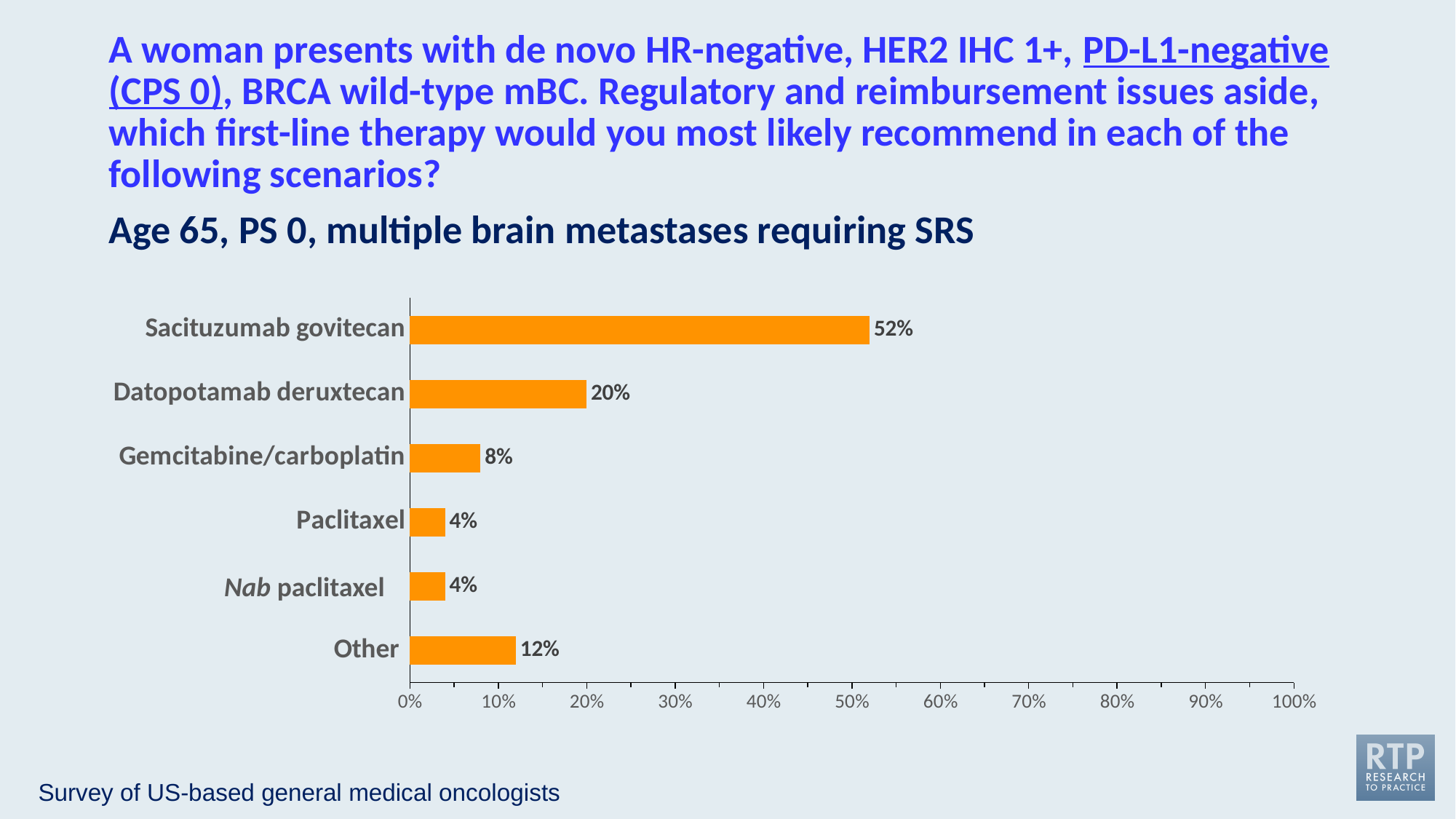
What is the difference between the values for Other and gemcitabine/carboplatin? 4% How many categories are shown in the chart? 6 What kind of chart is shown on the slide? Bar chart Is the value for sacituzumab govitecan greater or less than 50%? greater What percentage is shown for gemcitabine/carboplatin? 8% What is the value shown for datopotamab deruxtecan? 20% Which therapy has the highest percentage? Sacituzumab govitecan What is the maximum value shown on the horizontal axis? 100% What percentage of respondents chose sacituzumab govitecan? 52% Which is larger, the value for datopotamab deruxtecan or the value for Other? Datopotamab deruxtecan What is the difference between the values for sacituzumab govitecan and datopotamab deruxtecan? 32% What is the value for the Other category? 12%